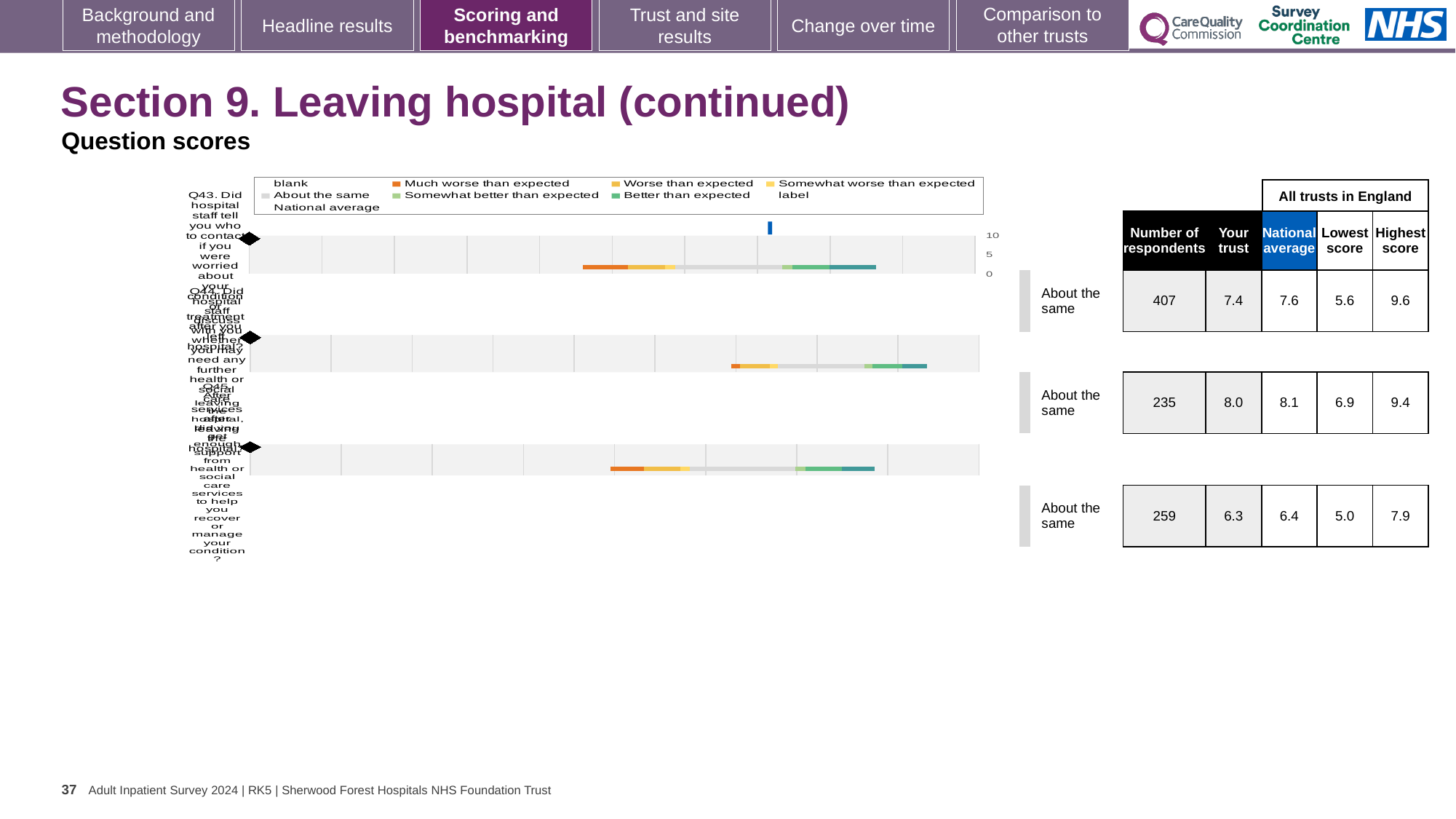
What benchmark category is shown beside each of the three charts? About the same In the chart legend, which category is shown in orange? Much worse than expected Which of the three charts has the highest 'Your trust' score? the middle chart For the middle chart, what is the 'Your trust' score shown beside it? 8.0 For the top chart (Q43), what is the national average score shown beside it? 7.6 For the top chart (Q43), what is the difference between the highest score and the lowest score among all trusts in England? 4.0 For the top chart (Q43), how many respondents are listed? 407 For the top chart (Q43), which is larger: the 'Your trust' score or the national average? National average What kind of chart is used to show the question scores on this slide? bar chart How many question charts are shown on the slide? 3 For the bottom chart, what is the lowest score among all trusts in England? 5.0 For the top chart (Q43), what is the 'Your trust' score shown in the table beside it? 7.4